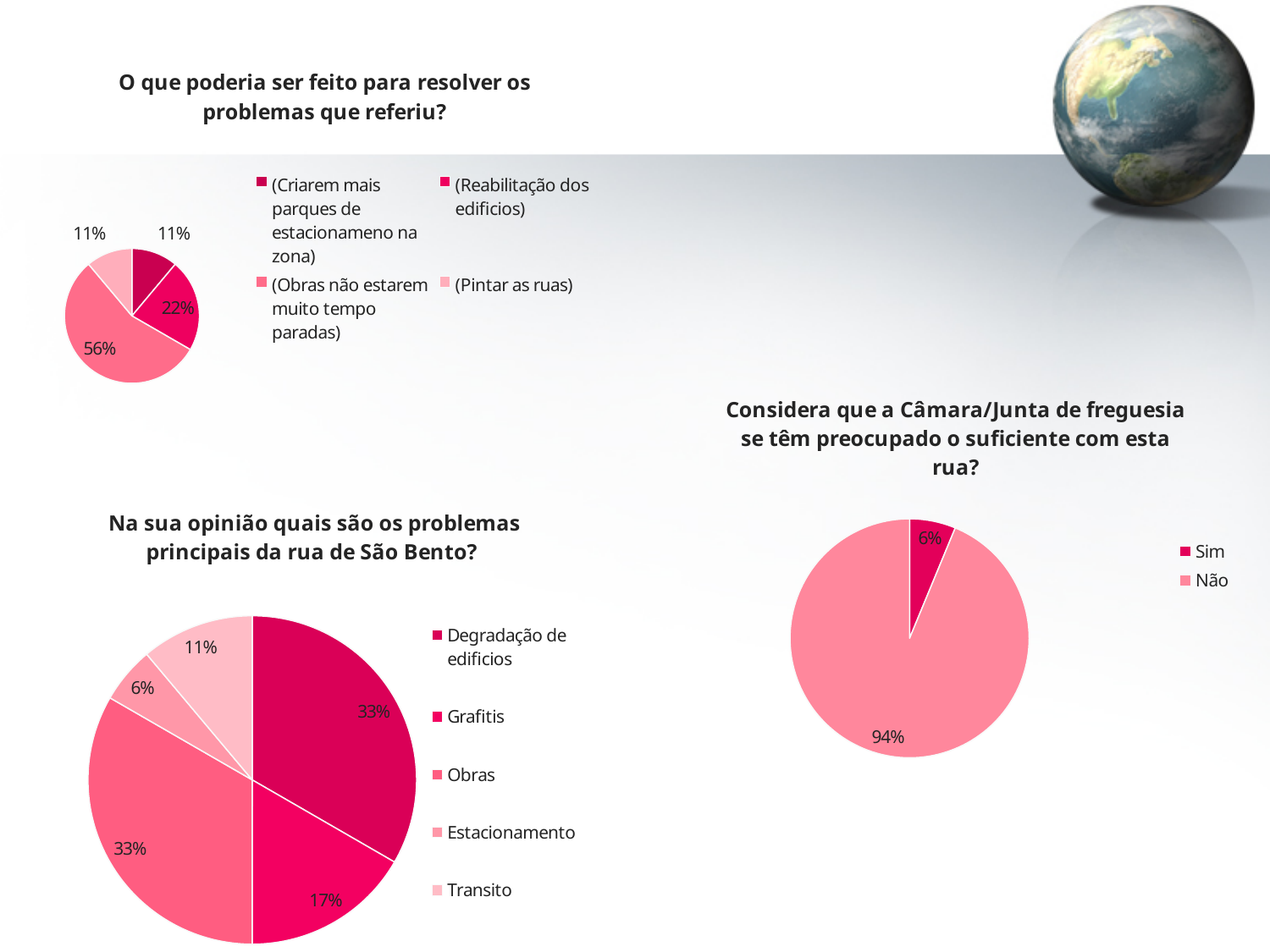
In the chart titled "Na sua opinião quais são os problemas principais da rua de São Bento?", which category has the smallest share? Estacionamento In the chart titled "Na sua opinião quais são os problemas principais da rua de São Bento?", what is the value for Grafitis? 17% In the chart titled "O que poderia ser feito para resolver os problemas que referiu?", what is the value for "(Obras não estarem muito tempo paradas)"? 56% What kind of chart is used for "Na sua opinião quais são os problemas principais da rua de São Bento?"? Pie chart In the chart titled "Considera que a Câmara/Junta de freguesia se têm preocupado o suficiente com esta rua?", what is the difference between the "Não" and "Sim" shares? 88% In the chart titled "Na sua opinião quais são os problemas principais da rua de São Bento?", how many categories does the legend list? 5 In the chart titled "O que poderia ser feito para resolver os problemas que referiu?", what is the value for "(Reabilitação dos edificios)"? 22% In the chart titled "Na sua opinião quais são os problemas principais da rua de São Bento?", what is the value for Estacionamento? 6% In the chart titled "Considera que a Câmara/Junta de freguesia se têm preocupado o suficiente com esta rua?", what share of respondents answered "Sim"? 6% In the chart titled "Na sua opinião quais são os problemas principais da rua de São Bento?", which is larger, Transito or Estacionamento? Transito In the chart titled "O que poderia ser feito para resolver os problemas que referiu?", which category has the largest share? (Obras não estarem muito tempo paradas) In the chart titled "Considera que a Câmara/Junta de freguesia se têm preocupado o suficiente com esta rua?", what share of respondents answered "Não"? 94%